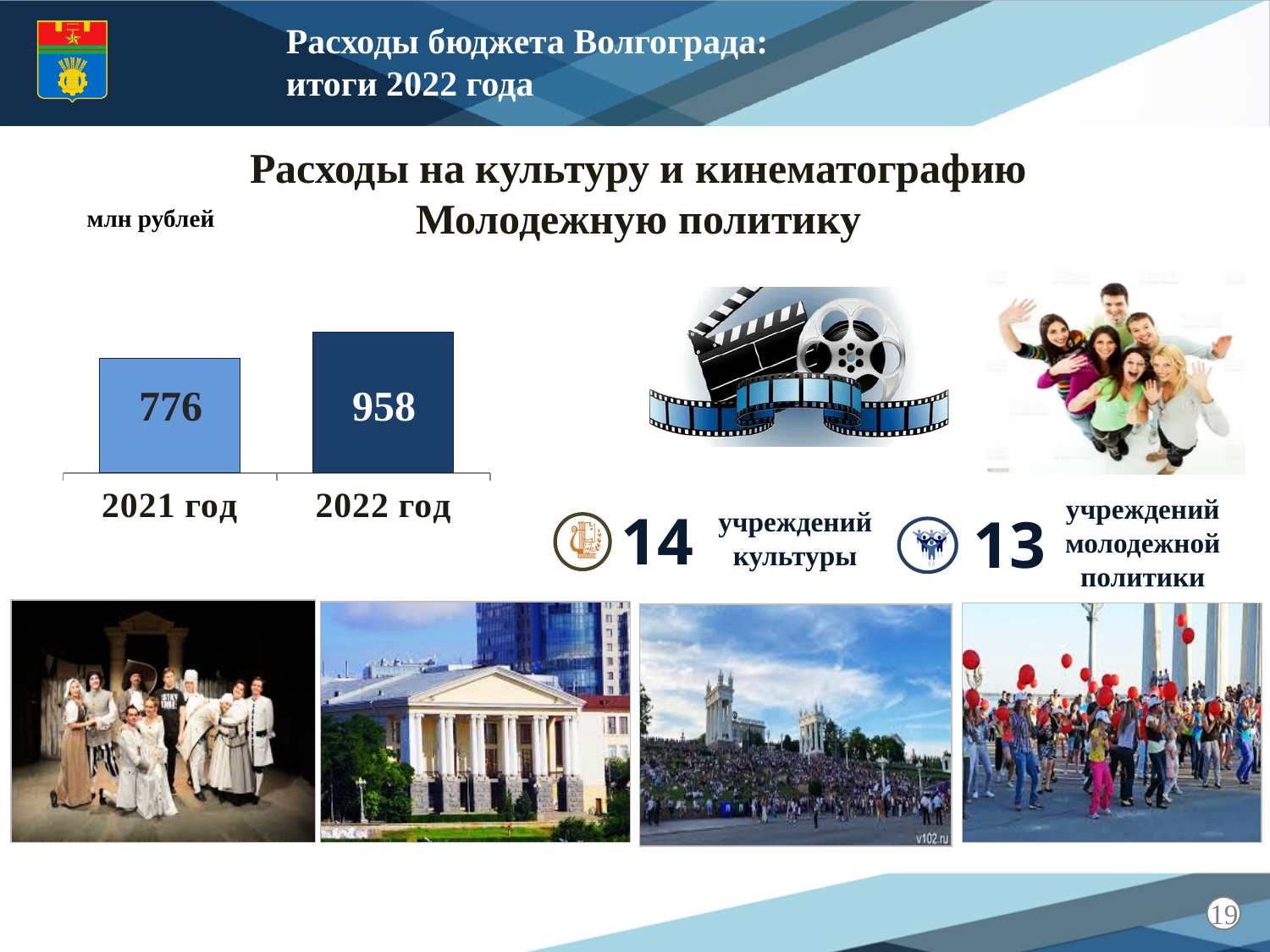
Do the values rise or fall from 2021 год to 2022 год? rise How many categories (years) are shown in the chart? 2 What is the value for 2022 год? 958 What unit is indicated for the chart values? млн рублей Which year has the lower value? 2021 год What is the difference between the values for 2022 год and 2021 год? 182 Is the value for 2022 год larger or smaller than the value for 2021 год? larger Which year has the higher value? 2022 год What kind of chart is shown on the slide? bar chart What is the title of the chart? Расходы на культуру и кинематографию Молодежную политику What is the value for 2021 год? 776